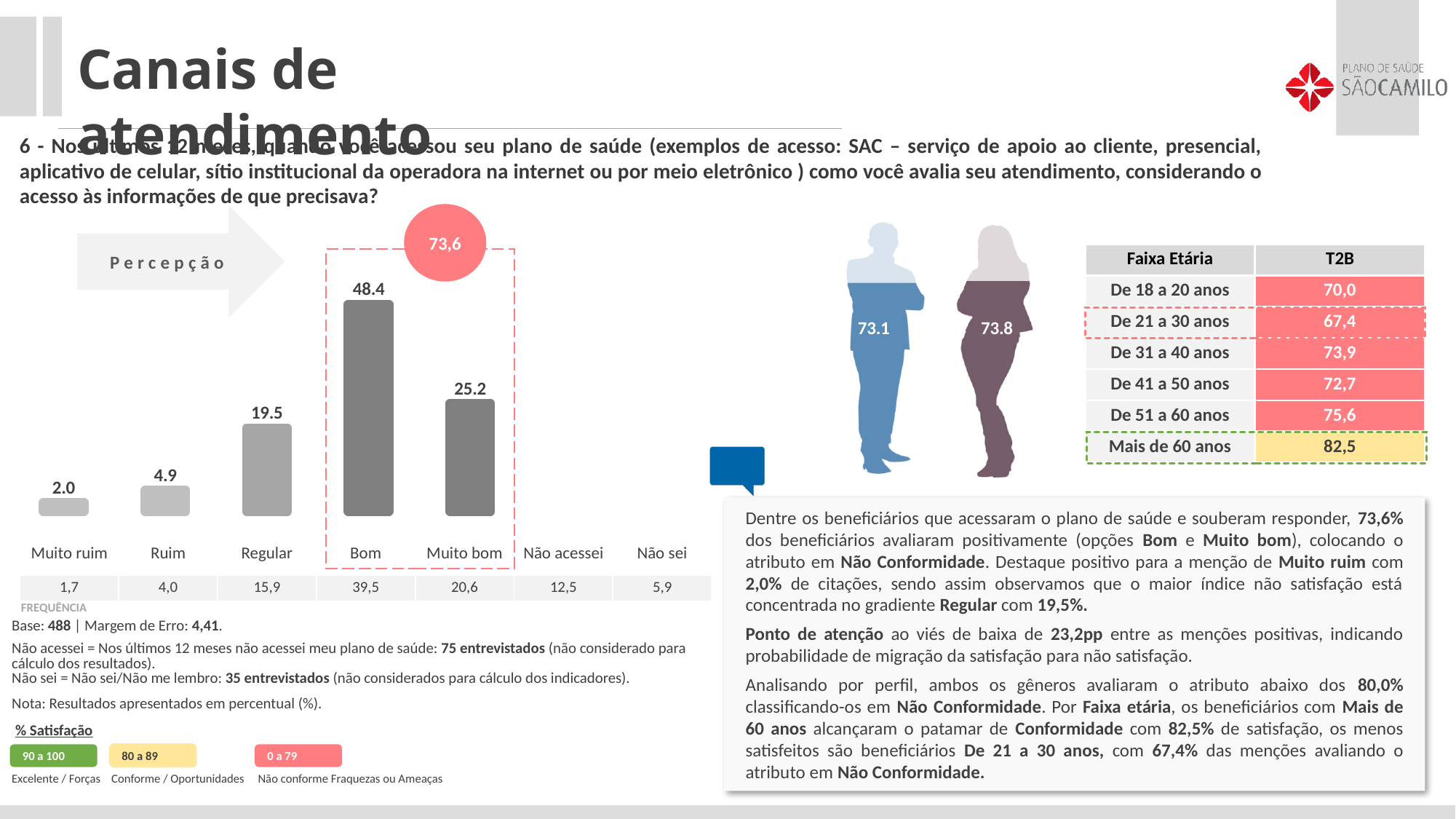
What type of chart is used to show the evaluation categories (Muito ruim to Muito bom)? bar chart What is the value shown for the 'Muito ruim' bar in the bar chart? 2.0 What is the value shown for the 'Bom' bar in the bar chart? 48.4 How many categories have a bar plotted in the bar chart? 5 What is the difference between the 'Bom' and 'Muito bom' values in the bar chart? 23.2 What value is shown in the pink circle above the 'Bom' and 'Muito bom' bars? 73,6 Which category has the highest bar in the bar chart? Bom In the 'Faixa Etária' table, which age group has the lowest T2B value? De 21 a 30 anos In the 'Faixa Etária' table, what is the T2B value for 'Mais de 60 anos'? 82,5 Which category has the lowest bar in the bar chart? Muito ruim Which is larger in the bar chart, the value for 'Ruim' or the value for 'Regular'? Regular What is the value shown for the 'Regular' bar in the bar chart? 19.5